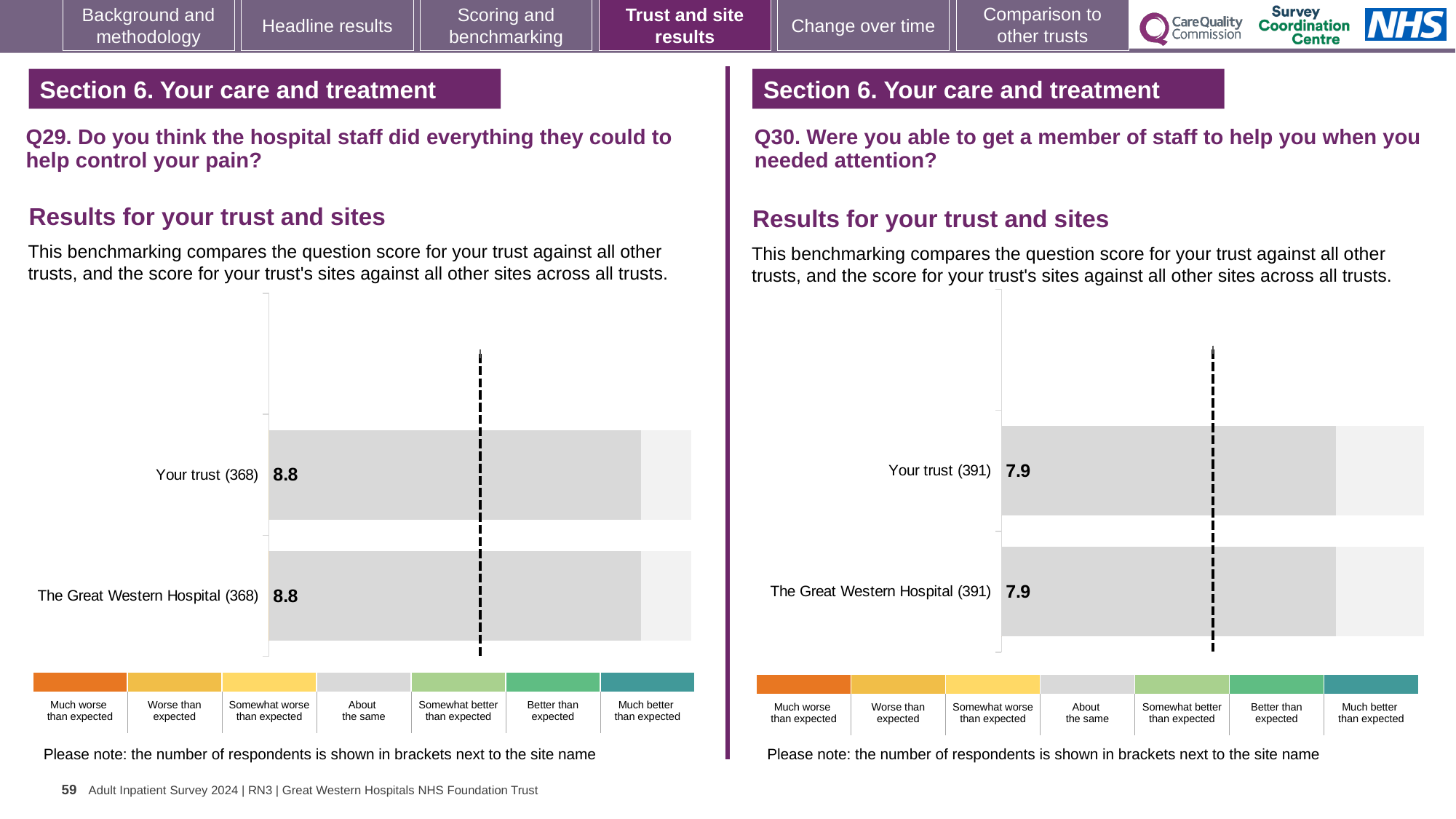
How many bars are plotted on the Q29 chart (left)? 2 On the Q29 chart (left), what is the score for Your trust? 8.8 On the Q29 chart (left), what is the score for The Great Western Hospital? 8.8 On the Q30 chart (right), what is the difference between the score for Your trust and the score for The Great Western Hospital? 0.0 On the Q29 chart (left), what is the difference between the score for Your trust and the score for The Great Western Hospital? 0.0 On the Q29 chart (left), how many respondents are shown in brackets for Your trust? 368 Is the score for Your trust on the Q29 chart (left) larger or smaller than the score for Your trust on the Q30 chart (right)? Larger On the Q30 chart (right), what is the score for The Great Western Hospital? 7.9 On the Q30 chart (right), how many respondents are shown in brackets for The Great Western Hospital? 391 On the Q30 chart (right), what is the score for Your trust? 7.9 What kind of chart is the Q29 chart (left)? Bar chart How many bars are plotted on the Q30 chart (right)? 2